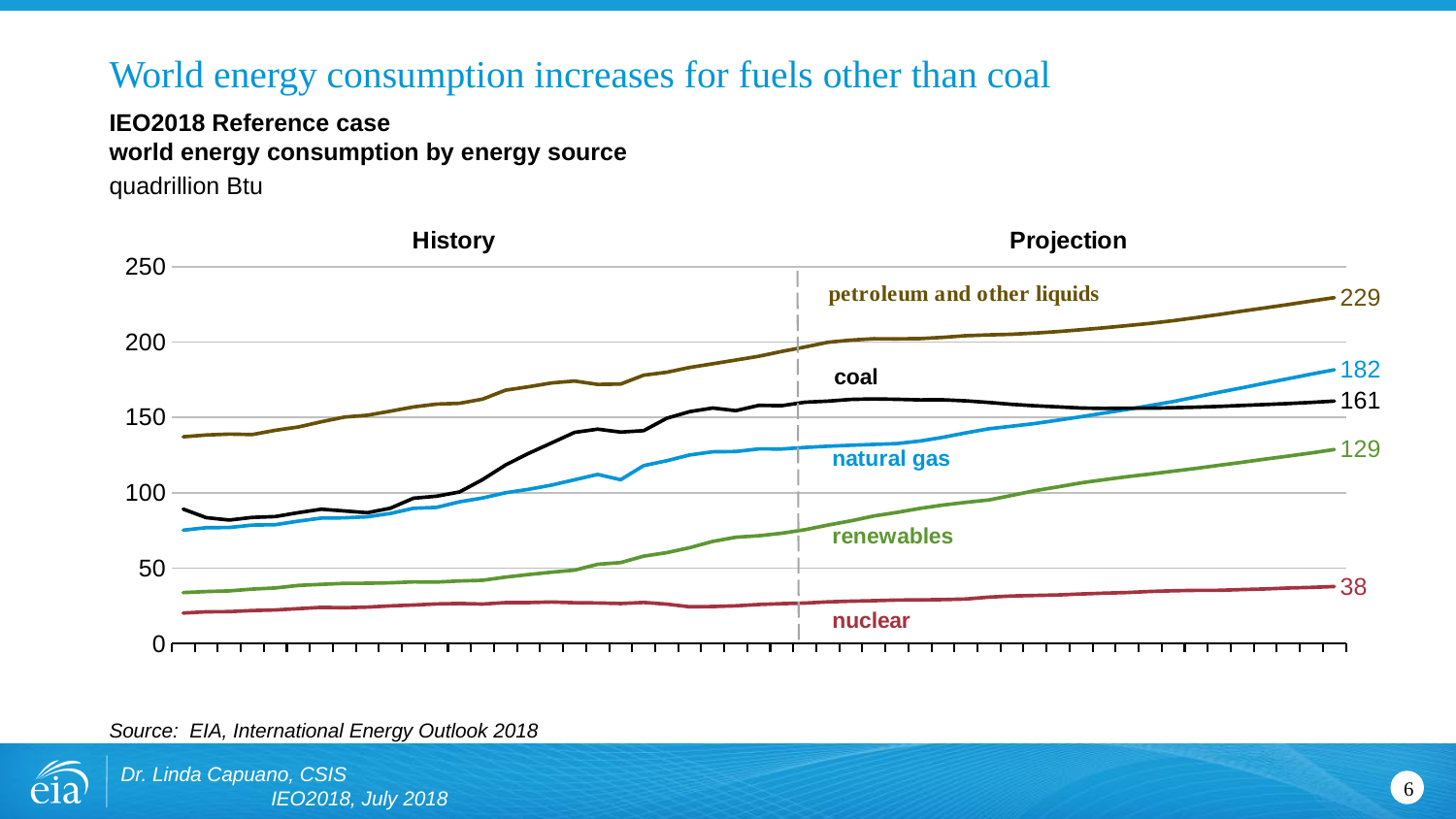
What is the difference between the final values for natural gas and coal? 21 What is the final projected value for natural gas? 182 At the start of the history period, is the value for coal greater or less than 100? less At the end of the projection, is the value for renewables or coal larger? coal How many energy sources are plotted on the chart? 5 What is the final projected value for renewables? 129 Which energy source has the highest consumption at the end of the projection period? petroleum and other liquids What is the final projected value for coal? 161 Which energy source has the lowest consumption at the end of the projection period? nuclear What unit is used for the values on the chart? quadrillion Btu What is the final projected value for petroleum and other liquids? 229 What is the final projected value for nuclear? 38